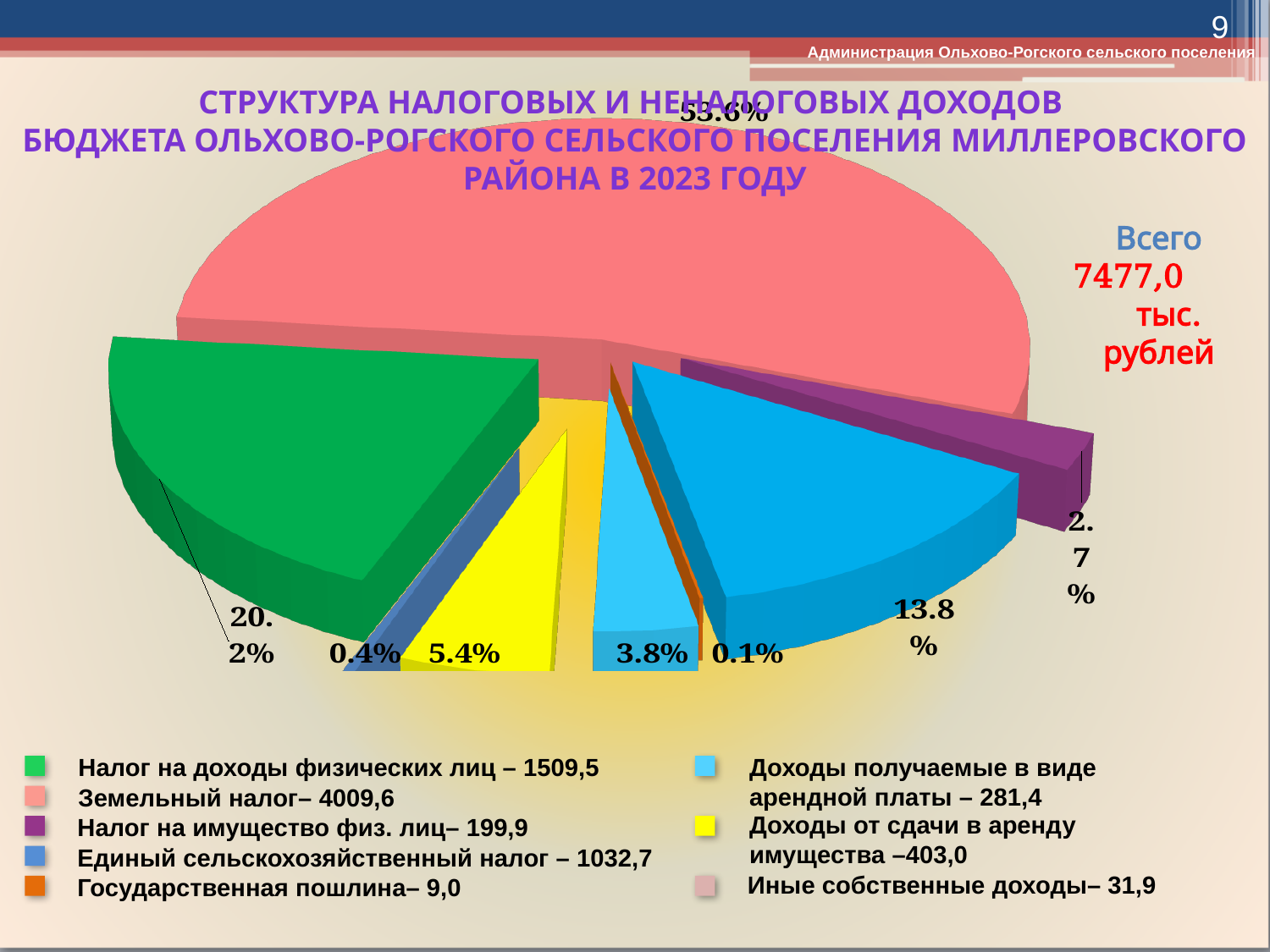
What value does the legend give for Налог на доходы физических лиц? 1509,5 What value does the legend give for Земельный налог? 4009,6 What value does the legend give for Государственная пошлина? 9,0 What is the total (Всего) amount shown on the slide? 7477,0 тыс. рублей What kind of chart is shown on the slide? pie chart What is the difference between Земельный налог and Налог на доходы физических лиц? 2500,1 What value does the legend give for Доходы от сдачи в аренду имущества? 403,0 Which category has the largest value in the legend? Земельный налог Which category has the smallest value in the legend? Государственная пошлина Which is larger: Единый сельскохозяйственный налог or Налог на доходы физических лиц? Налог на доходы физических лиц How many categories does the legend list? 8 What is the largest percentage label shown on the pie chart? 53.6%